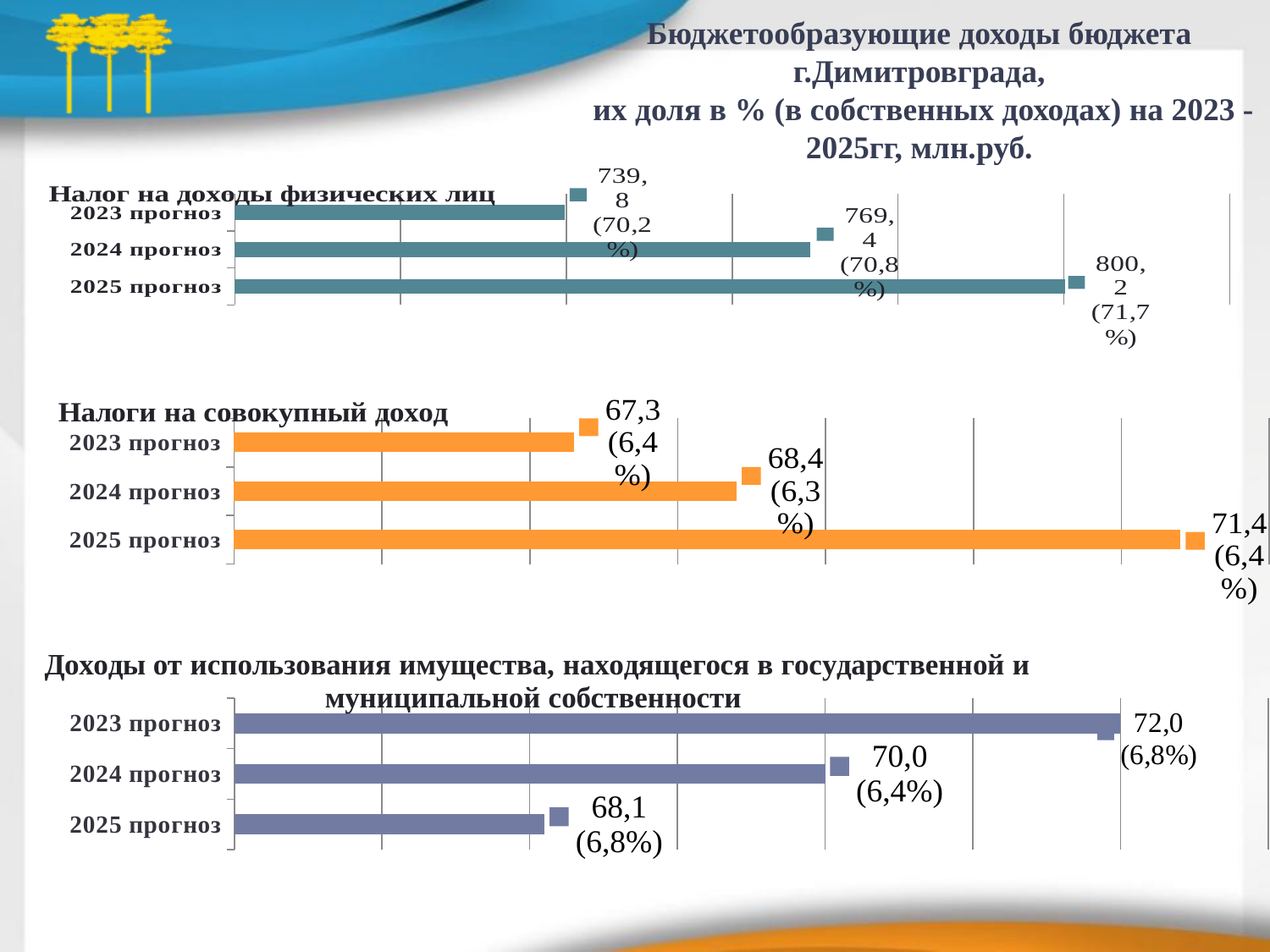
In the chart 'Налог на доходы физических лиц', what is the difference between the values for 2025 прогноз and 2023 прогноз? 60,4 What kind of chart is used for 'Налоги на совокупный доход'? bar chart In the bottom chart 'Доходы от использования имущества...', what is the difference between the values for 2023 прогноз and 2025 прогноз? 3,9 In the chart 'Налог на доходы физических лиц', which year has the highest value? 2025 прогноз In the bottom chart 'Доходы от использования имущества...', what is the value for 2025 прогноз? 68,1 In the chart 'Налог на доходы физических лиц', what is the value for 2023 прогноз? 739,8 In the chart 'Налоги на совокупный доход', do the values rise or fall from 2023 прогноз to 2025 прогноз? rise In the chart 'Налоги на совокупный доход', what is the value for 2024 прогноз? 68,4 In the bottom chart 'Доходы от использования имущества...', which year has the highest value? 2023 прогноз In the chart 'Налог на доходы физических лиц', what share in % is shown for 2025 прогноз? 71,7% In the bottom chart 'Доходы от использования имущества...', which is larger: the value for 2024 прогноз or 2025 прогноз? 2024 прогноз In the chart 'Налоги на совокупный доход', which year has the lowest value? 2023 прогноз